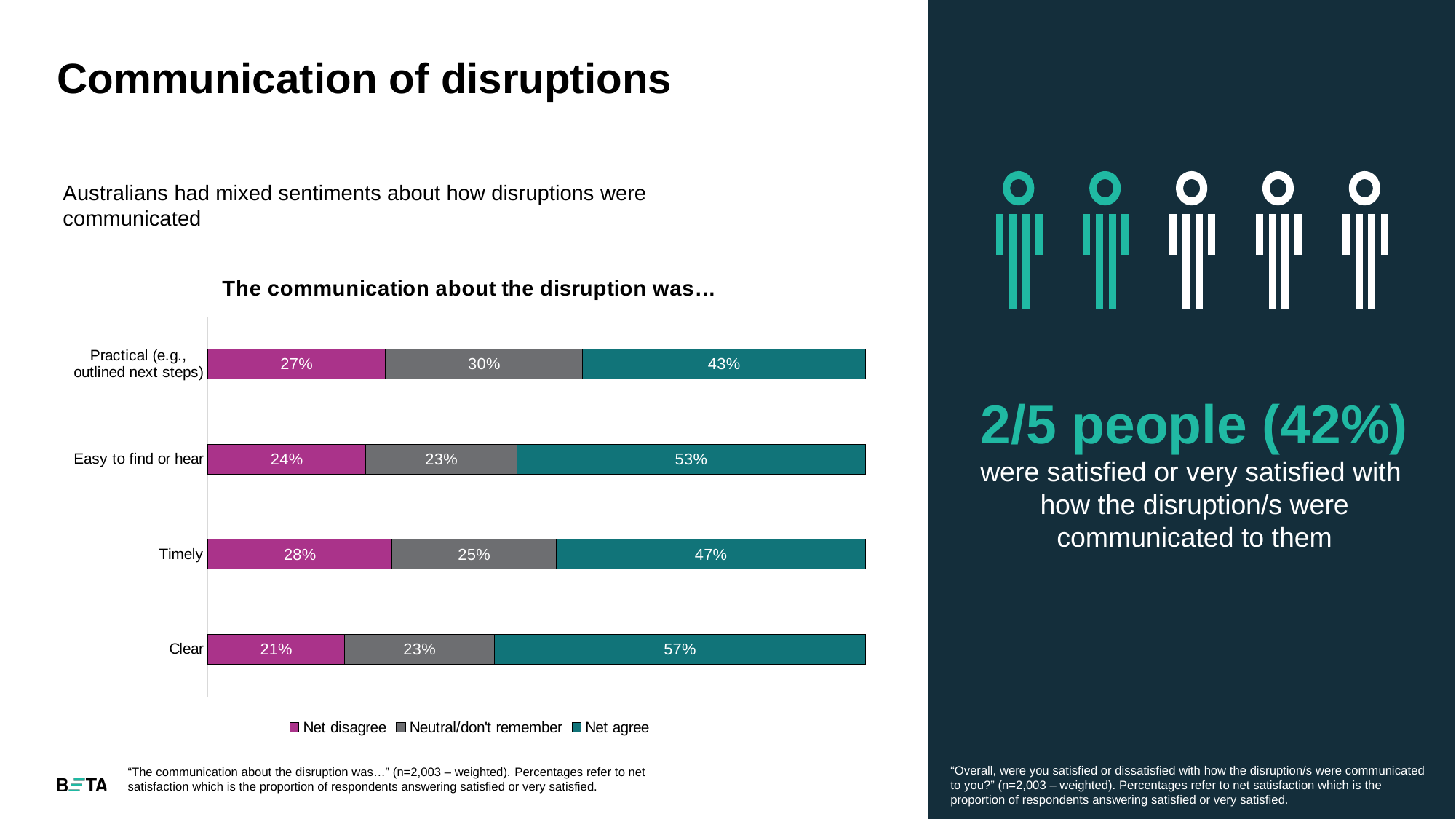
What is the total of the stacked bar for 'Practical (e.g., outlined next steps)'? 100% Which is larger: the Net agree value for 'Practical (e.g., outlined next steps)' or for 'Easy to find or hear'? Easy to find or hear What is the Net agree value for 'Clear'? 57% Which category has the highest Net agree value? Clear What is the difference between the Net agree values for 'Easy to find or hear' and 'Timely'? 6% What is the Neutral/don't remember value for 'Practical (e.g., outlined next steps)'? 30% How many series does the legend list? 3 What kind of chart is shown on the slide? Stacked bar chart What is the title of the chart? The communication about the disruption was… Which category has the lowest Net disagree value? Clear What is the Net disagree value for 'Timely'? 28% How many categories are shown in the chart? 4